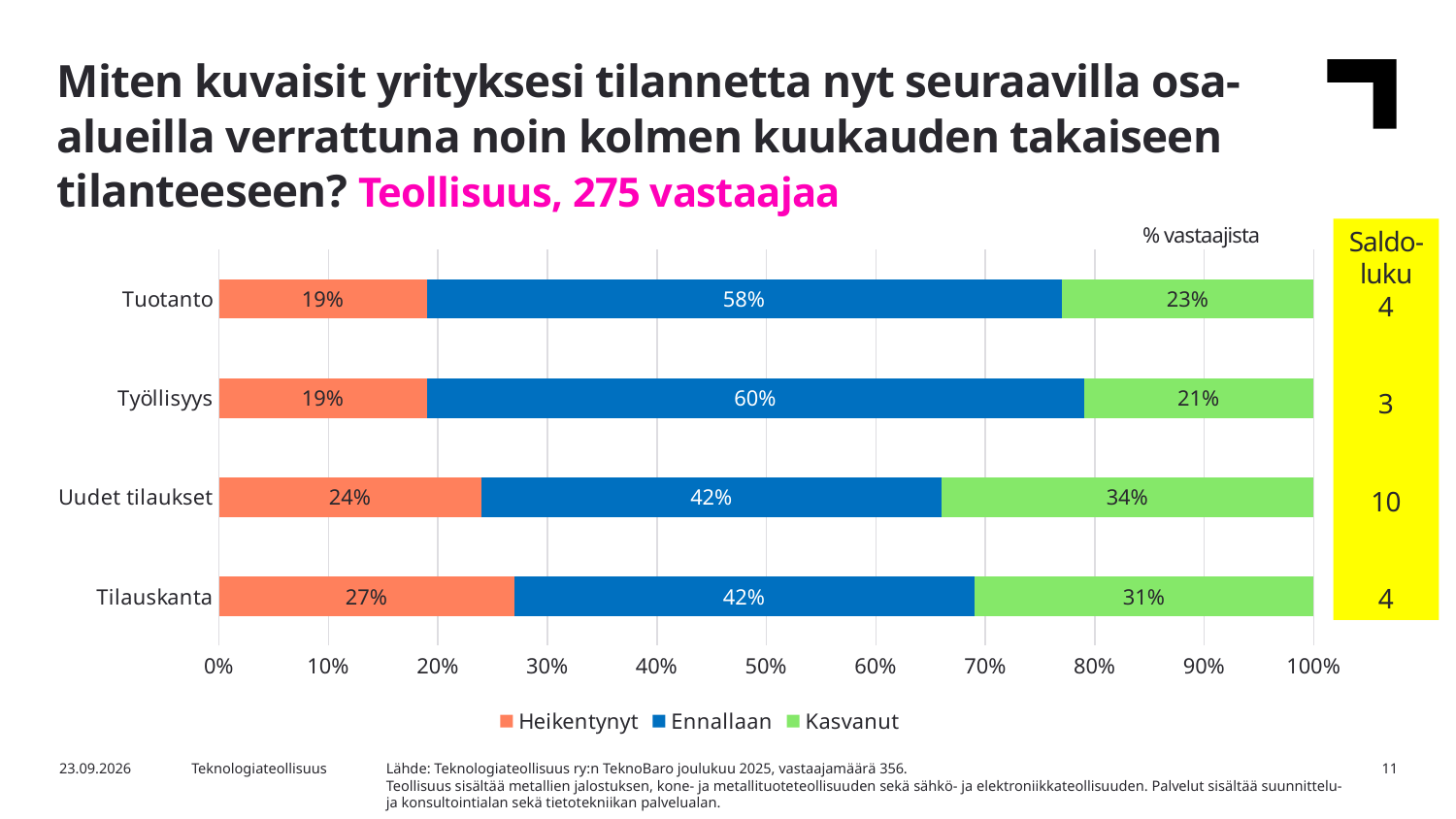
What is the "Kasvanut" value for Uudet tilaukset? 34% How many series does the legend list? 3 How many categories are shown on the chart? 4 Which is larger: the "Heikentynyt" value for Tilauskanta or for Työllisyys? Tilauskanta What is the "Heikentynyt" value for Tilauskanta? 27% What is the difference between the "Kasvanut" values for Uudet tilaukset and Tuotanto? 11 percentage points Which category has the highest "Kasvanut" share? Uudet tilaukset What is the total of the stacked bar for Työllisyys? 100% What kind of chart is shown on the slide? Stacked bar chart Which category has the lowest "Ennallaan" share? Uudet tilaukset and Tilauskanta (both 42%) What is the Saldoluku value shown for Uudet tilaukset? 10 What percentage of respondents answered "Ennallaan" for Tuotanto? 58%